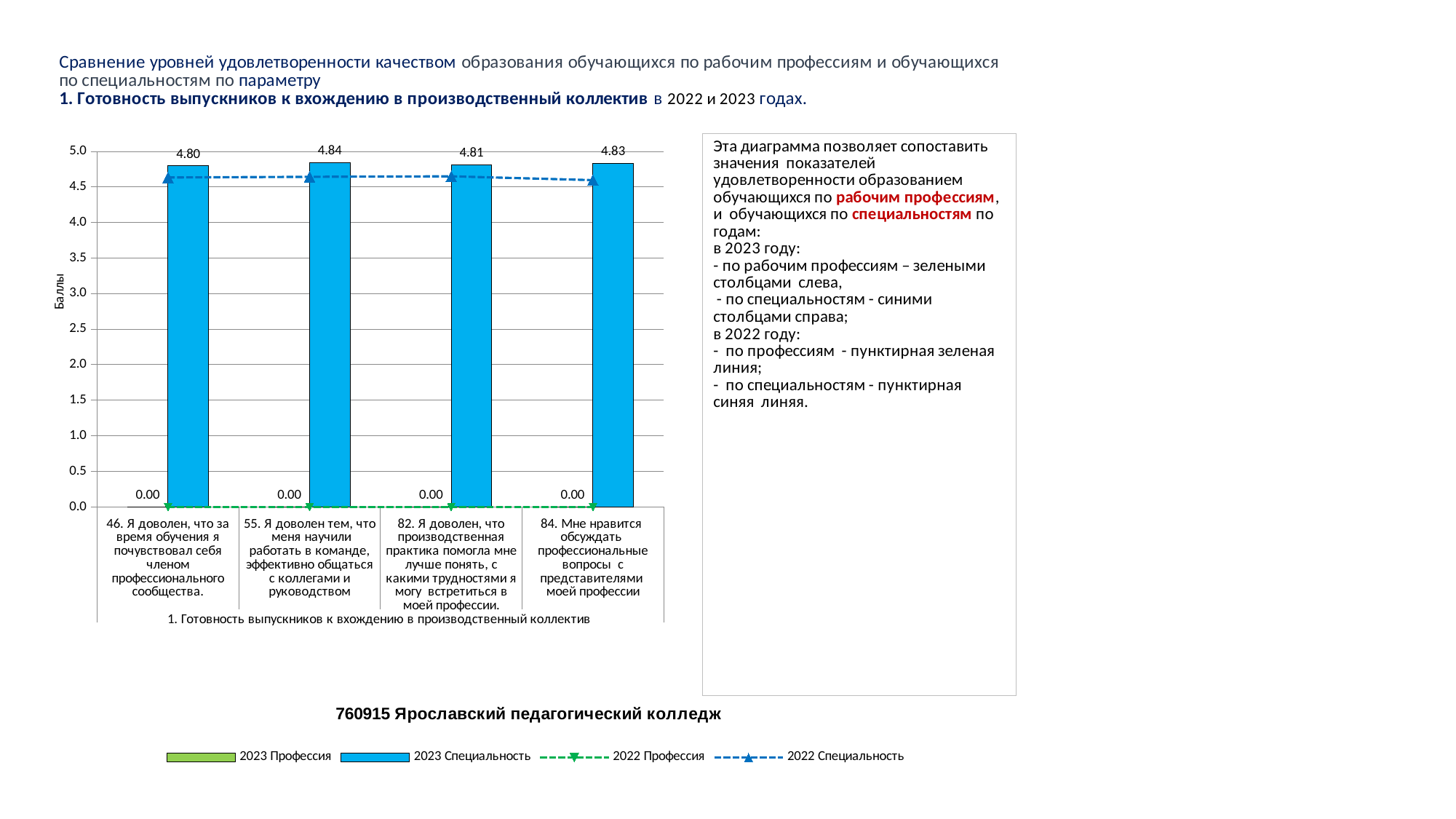
What is the value of the 2023 Специальность bar for category 55 (Я доволен тем, что меня научили работать в команде)? 4.84 What is the difference between the 2023 Специальность values for category 55 and category 46? 0.04 What is the value of the 2023 Специальность bar for category 46 (Я доволен, что за время обучения я почувствовал себя членом профессионального сообщества)? 4.80 How many series does the legend list? 4 Is the 2022 Специальность value for category 84 greater or less than 4.0? greater What is the label of the y axis? Баллы Which category has the highest 2023 Специальность value? 55. Я доволен тем, что меня научили работать в команде, эффективно общаться с коллегами и руководством What is the value of the 2023 Профессия series for category 46? 0.00 What is the value of the 2023 Специальность bar for category 84 (Мне нравится обсуждать профессиональные вопросы)? 4.83 How many categories are shown on the x axis of the chart? 4 What is the value of the 2023 Специальность bar for category 82 (производственная практика помогла мне лучше понять)? 4.81 Which category has the lowest 2023 Специальность value? 46. Я доволен, что за время обучения я почувствовал себя членом профессионального сообщества.